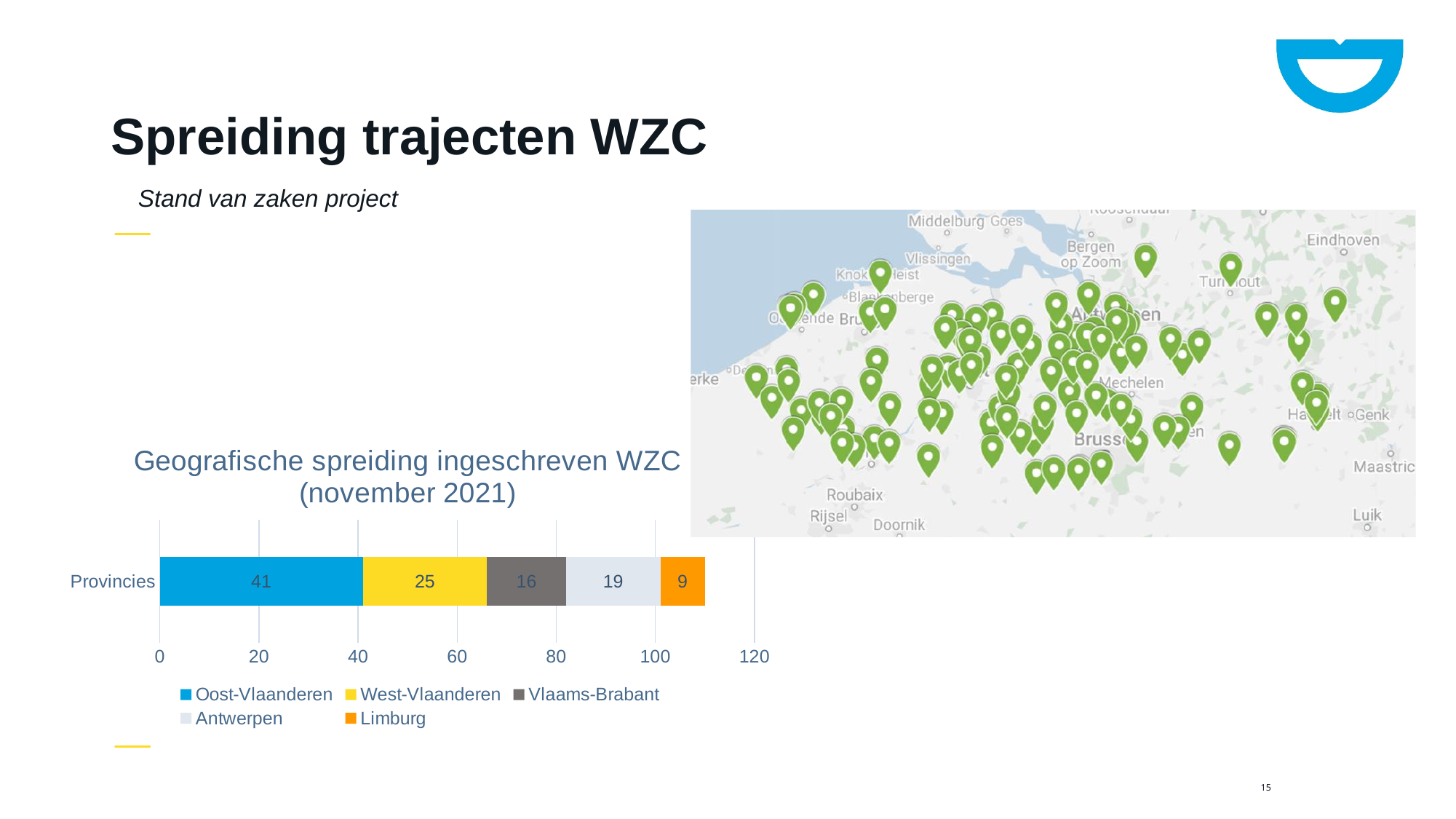
What is the title of the chart? Geografische spreiding ingeschreven WZC (november 2021) Which province has the lowest value in the chart? Limburg What is the value for Limburg in the stacked bar? 9 What is the difference between the values for Oost-Vlaanderen and West-Vlaanderen? 16 What is the value for Vlaams-Brabant in the stacked bar? 16 Which is larger, the value for Antwerpen or the value for Vlaams-Brabant? Antwerpen Which province has the highest value in the chart? Oost-Vlaanderen How many series does the legend list? 5 What is the value for Antwerpen in the stacked bar? 19 What is the value for West-Vlaanderen in the stacked bar? 25 What is the value for Oost-Vlaanderen in the stacked bar? 41 What is the total of the stacked bar for Provincies? 110